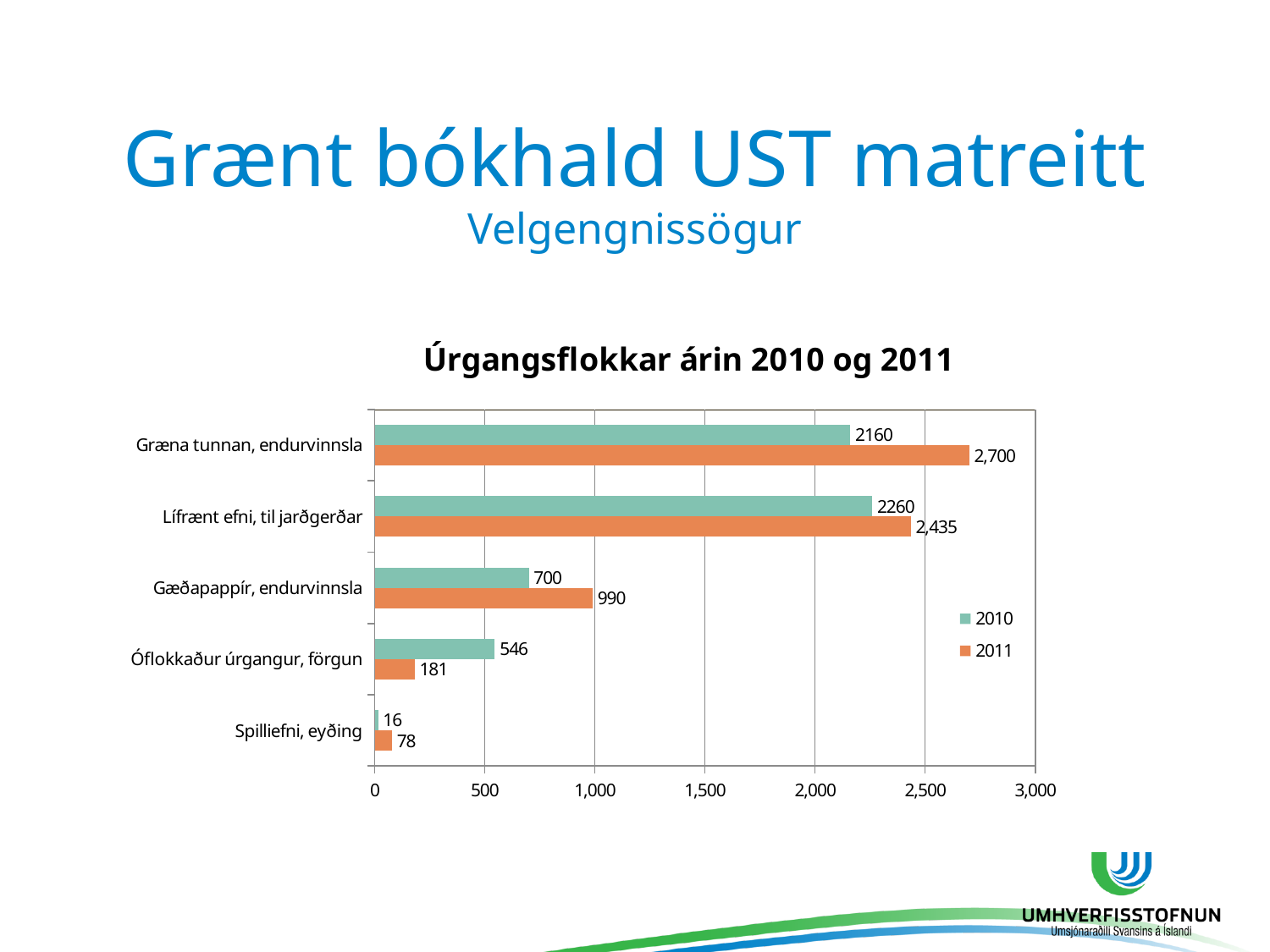
What is the 2010 value for Spilliefni, eyðing? 16 Which category has the highest 2011 value? Græna tunnan, endurvinnsla What is the 2011 value for Græna tunnan, endurvinnsla? 2,700 How many series does the legend list? 2 How many categories are shown in the chart? 5 What is the title of the chart? Úrgangsflokkar árin 2010 og 2011 What is the 2010 value for Lífrænt efni, til jarðgerðar? 2260 What kind of chart is shown on the slide? Bar chart What is the 2011 value for Gæðapappír, endurvinnsla? 990 What is the difference between the 2011 and 2010 values for Óflokkaður úrgangur, förgun? 365 Which category has the lowest 2010 value? Spilliefni, eyðing For Gæðapappír, endurvinnsla, which year has the larger value, 2010 or 2011? 2011